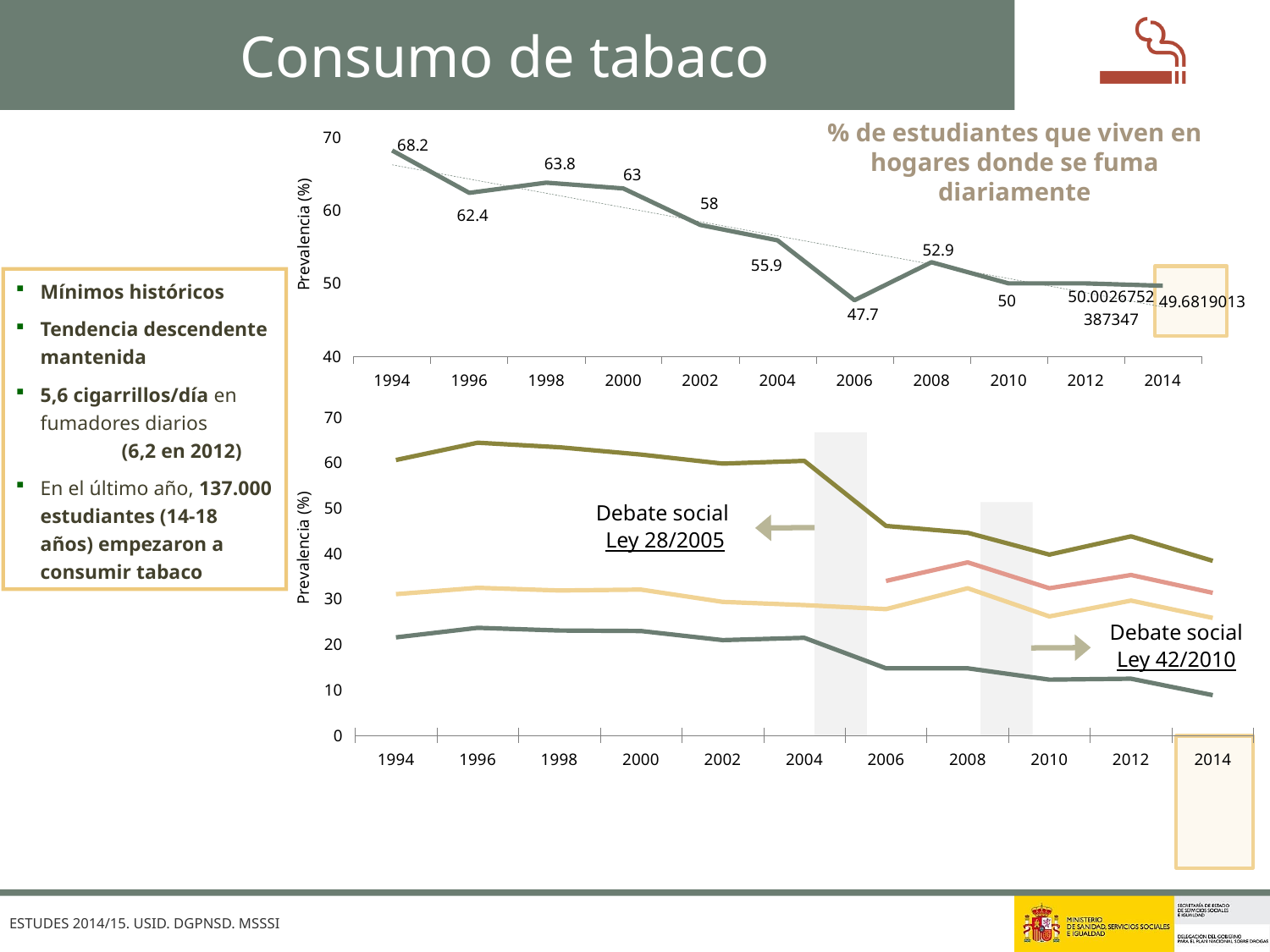
In the top chart, what is the value for 2008? 52.9 In the top chart, what is the value for 2006? 47.7 In the bottom chart, is the value of the lowest line in 2006 greater or less than 20? less What kind of chart is the top chart? Line chart In the top chart, which year has the highest value? 1994 In the top chart, which year has the lowest value? 2006 In the top chart, do the values generally rise or fall from 1994 to 2014? Fall In the top chart, what is the difference between the values for 1994 and 2006? 20.5 In the top chart, how many years are plotted on the x axis? 11 In the top chart (% de estudiantes que viven en hogares donde se fuma diariamente), what is the value for 1994? 68.2 In the bottom chart, is the value of the highest line in 1996 greater or less than 60? greater In the top chart, which year has the larger value, 1998 or 2000? 1998